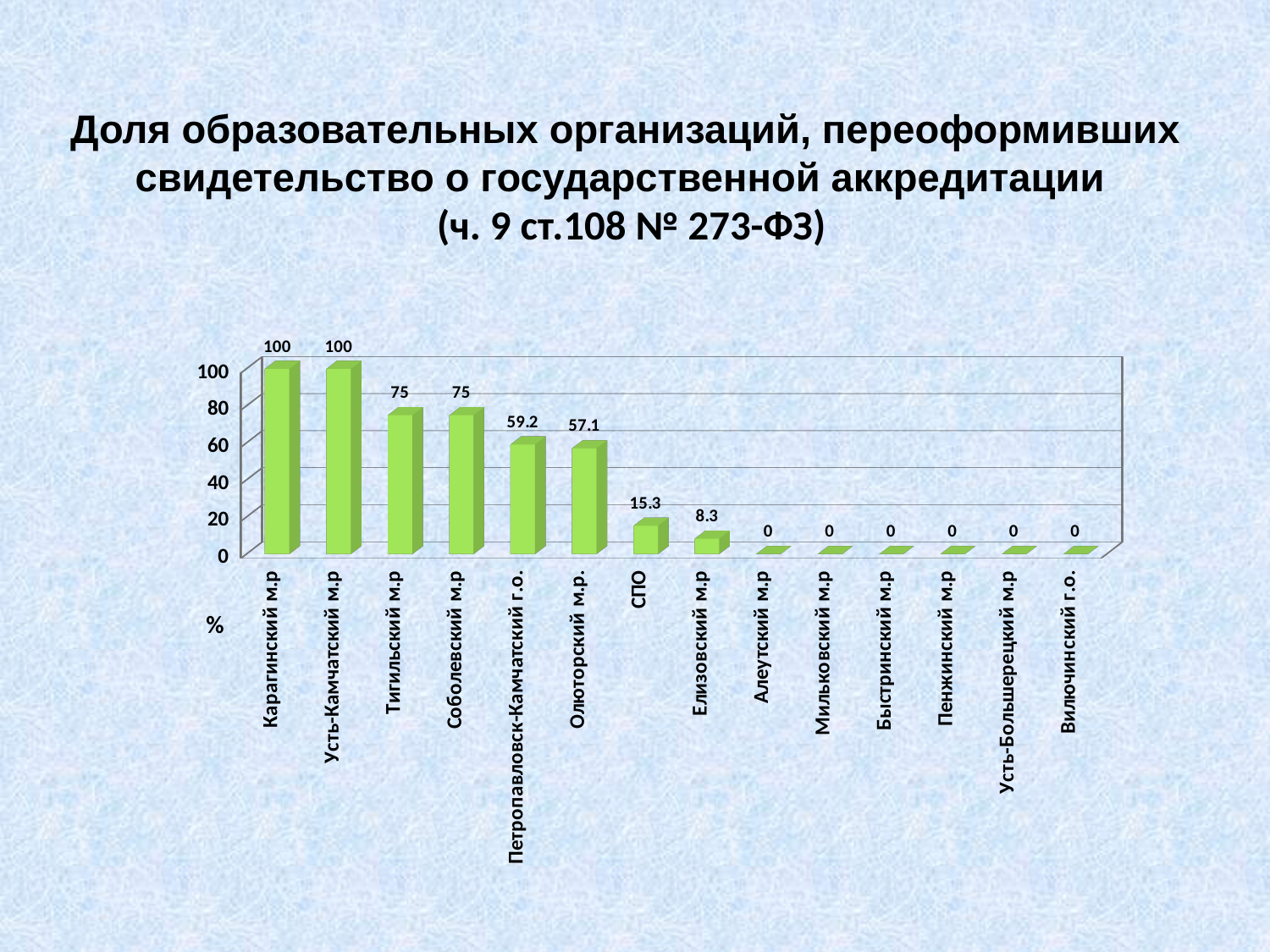
Which has a larger value, СПО or Елизовский м.р? СПО What is the difference between the values for Петропавловск-Камчатский г.о. and Олюторский м.р.? 2.1 What kind of chart is shown on the slide? bar chart What is the value for Тигильский м.р? 75 What is the difference between the values for Карагинский м.р and Соболевский м.р? 25 What is the value for Елизовский м.р? 8.3 Is the value for Елизовский м.р greater or less than 20? less What is the highest value shown on the chart? 100 What is the value for Олюторский м.р.? 57.1 How many categories are shown on the x axis of the chart? 14 What is the value for СПО? 15.3 What is the value for Петропавловск-Камчатский г.о.? 59.2